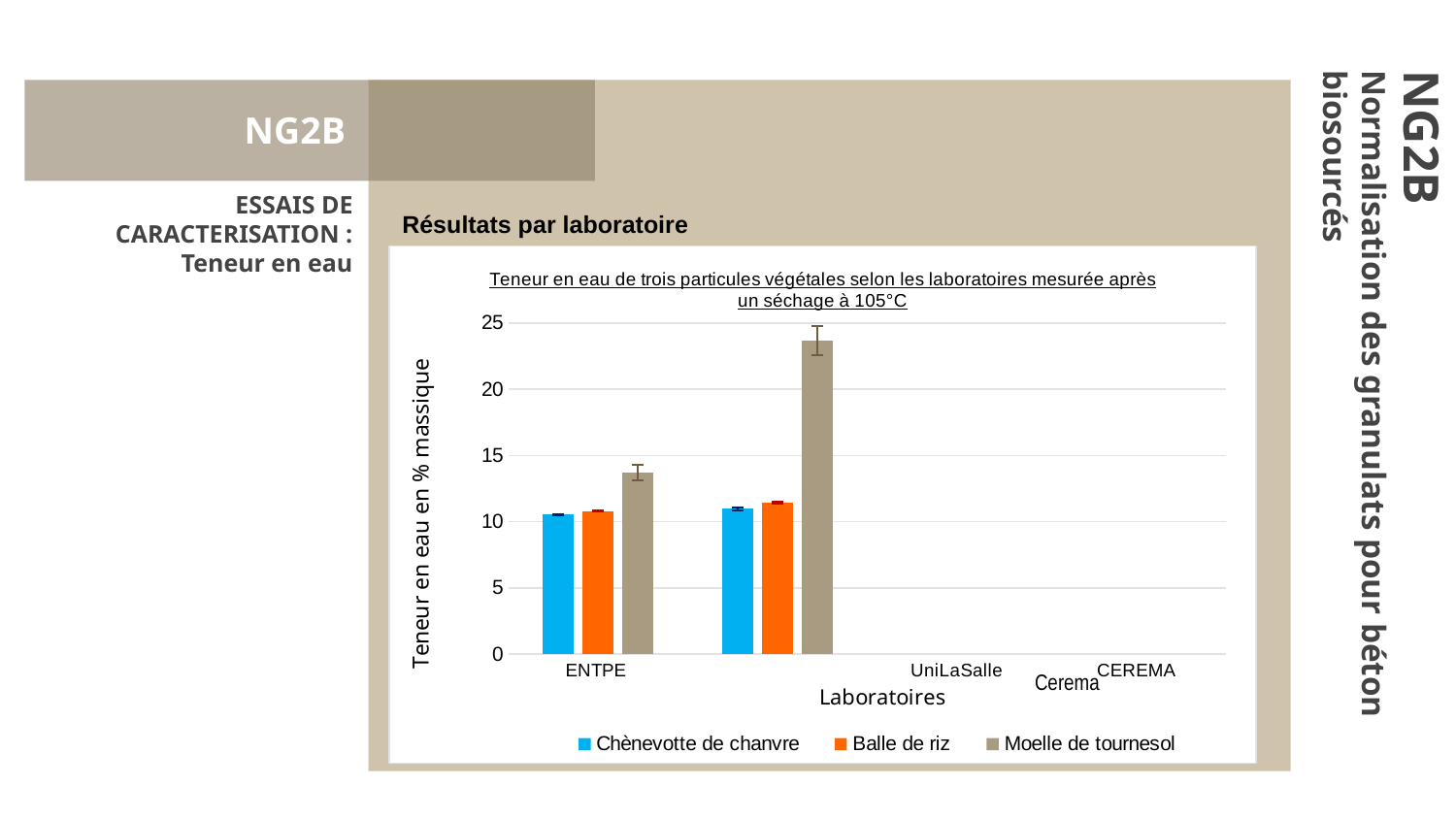
For ENTPE, which is larger: Moelle de tournesol or Balle de riz? Moelle de tournesol What is the label of the vertical axis of the chart? Teneur en eau en % massique Is the tallest bar on the chart greater or less than 20? greater For ENTPE, which series has the highest water content? Moelle de tournesol Which series are listed in the chart legend? Chènevotte de chanvre, Balle de riz, Moelle de tournesol What kind of chart is shown on the slide? bar chart How many series does the chart legend list? 3 Which series has the tallest bar anywhere on the chart? Moelle de tournesol For ENTPE, is the value for Chènevotte de chanvre greater or less than 15? less What is the highest value shown on the vertical axis of the chart? 25 For ENTPE, is the value for Moelle de tournesol greater or less than 10? greater